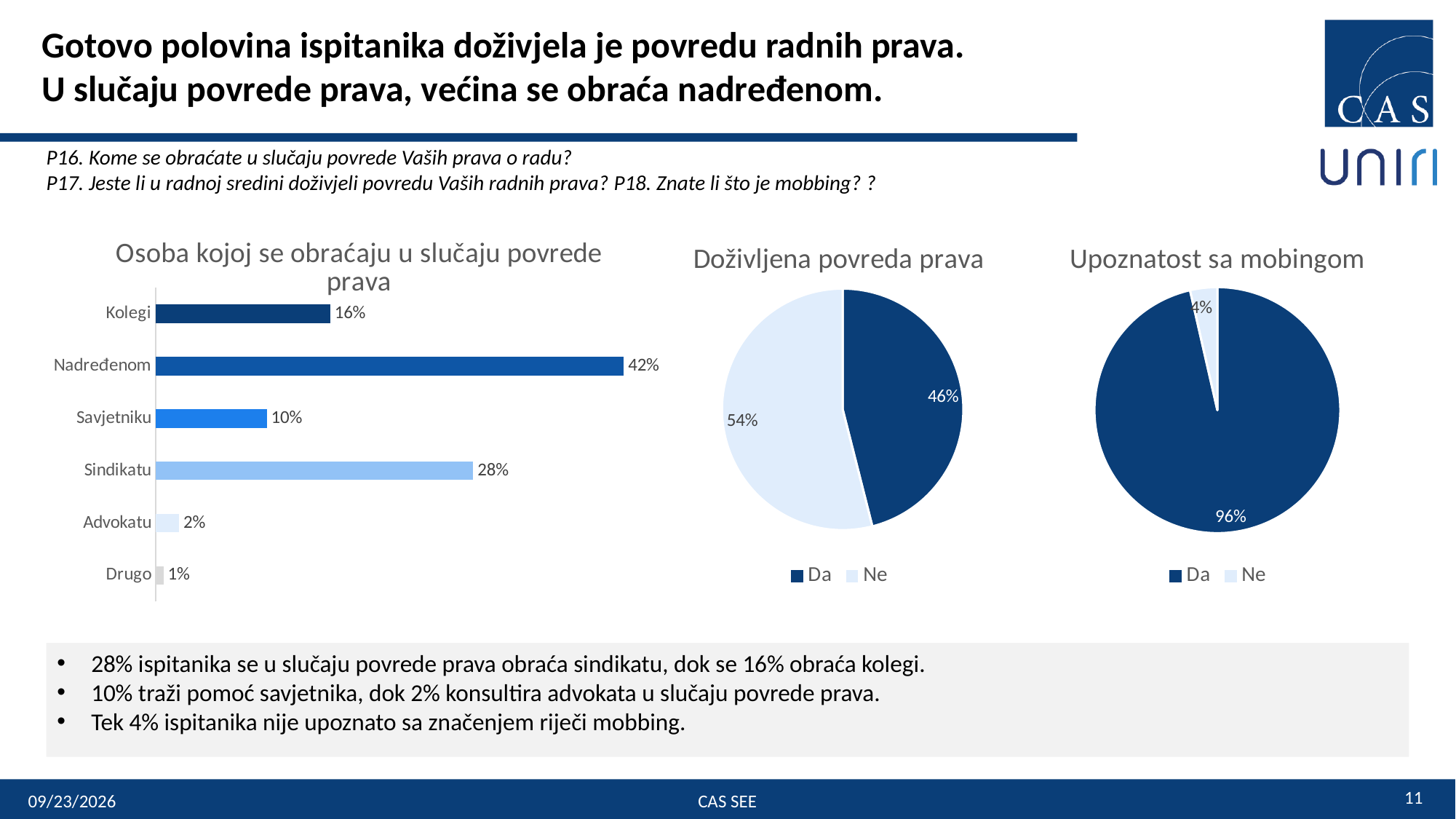
In the bar chart 'Osoba kojoj se obraćaju u slučaju povrede prava', what is the value for Nadređenom? 42% In the bar chart 'Osoba kojoj se obraćaju u slučaju povrede prava', which category has the highest value? Nadređenom In the bar chart 'Osoba kojoj se obraćaju u slučaju povrede prava', what is the difference between Nadređenom and Sindikatu? 14% In the bar chart 'Osoba kojoj se obraćaju u slučaju povrede prava', which is larger: Kolegi or Savjetniku? Kolegi In the bar chart 'Osoba kojoj se obraćaju u slučaju povrede prava', what is the value for Sindikatu? 28% In the bar chart 'Osoba kojoj se obraćaju u slučaju povrede prava', which category has the lowest value? Drugo In the pie chart 'Doživljena povreda prava', which slice is larger: Da or Ne? Ne How many entries does the legend of the pie chart 'Upoznatost sa mobingom' list? 2 How many categories are shown in the bar chart 'Osoba kojoj se obraćaju u slučaju povrede prava'? 6 What kind of chart is 'Osoba kojoj se obraćaju u slučaju povrede prava'? Bar chart In the pie chart 'Upoznatost sa mobingom', what share is 'Ne'? 4% In the pie chart 'Doživljena povreda prava', what share is 'Da'? 46%